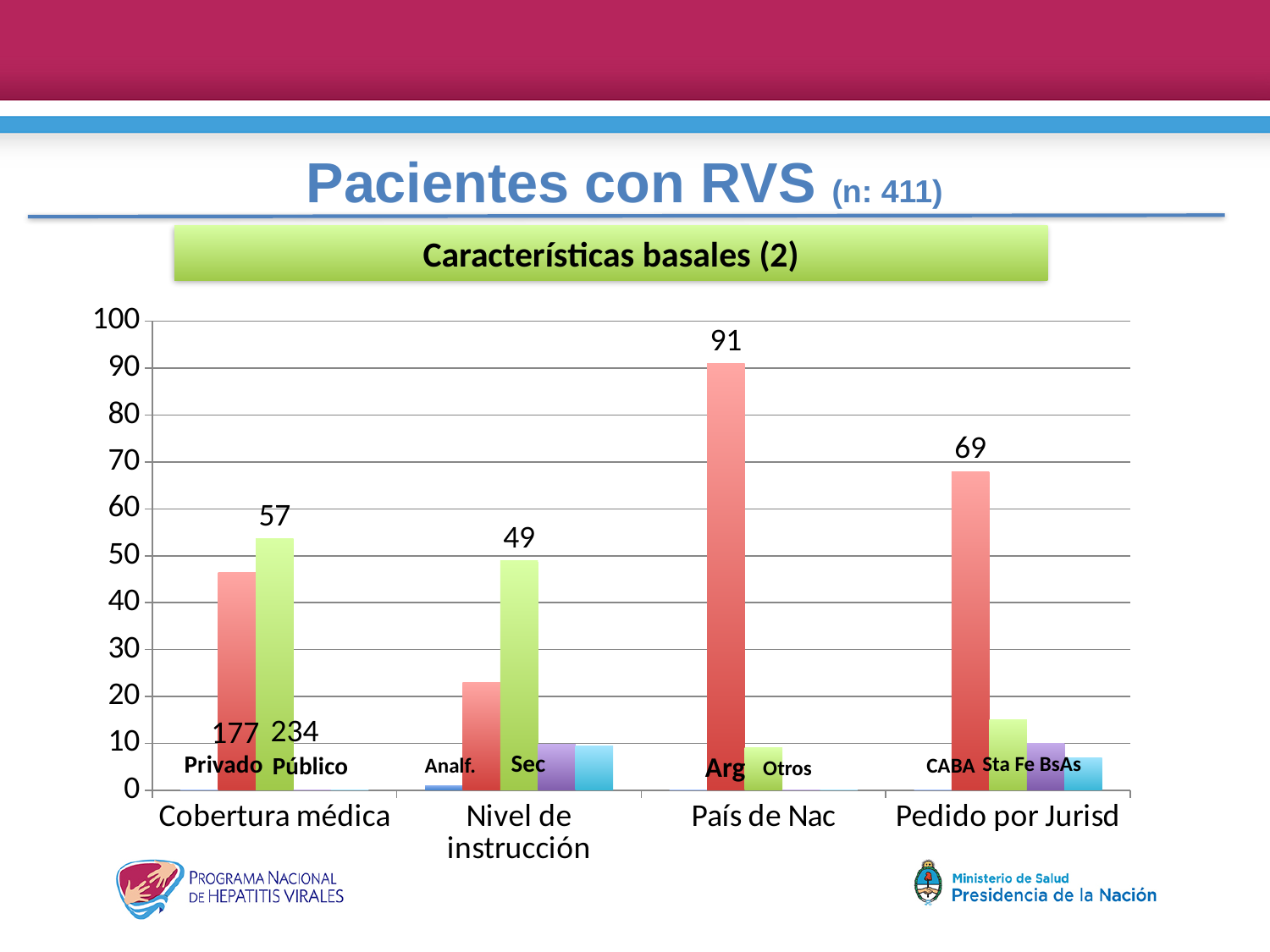
Which bar has the highest value in the chart? Arg What kind of chart is shown on the slide? bar chart What is the value for Público in the Cobertura médica group? 57 What is the difference between the values for Arg and CABA? 22 What is the value for CABA in the Pedido por Jurisd group? 69 What is the value for Sec in the Nivel de instrucción group? 49 Is the value for Otros greater or less than 20? less Which is larger, the value for CABA or the value for Sec? CABA What is the difference between the values for Público and Sec? 8 Is the value for Privado greater or less than 40? greater How many category groups are shown along the x axis? 4 What is the value for Arg in the País de Nac group? 91